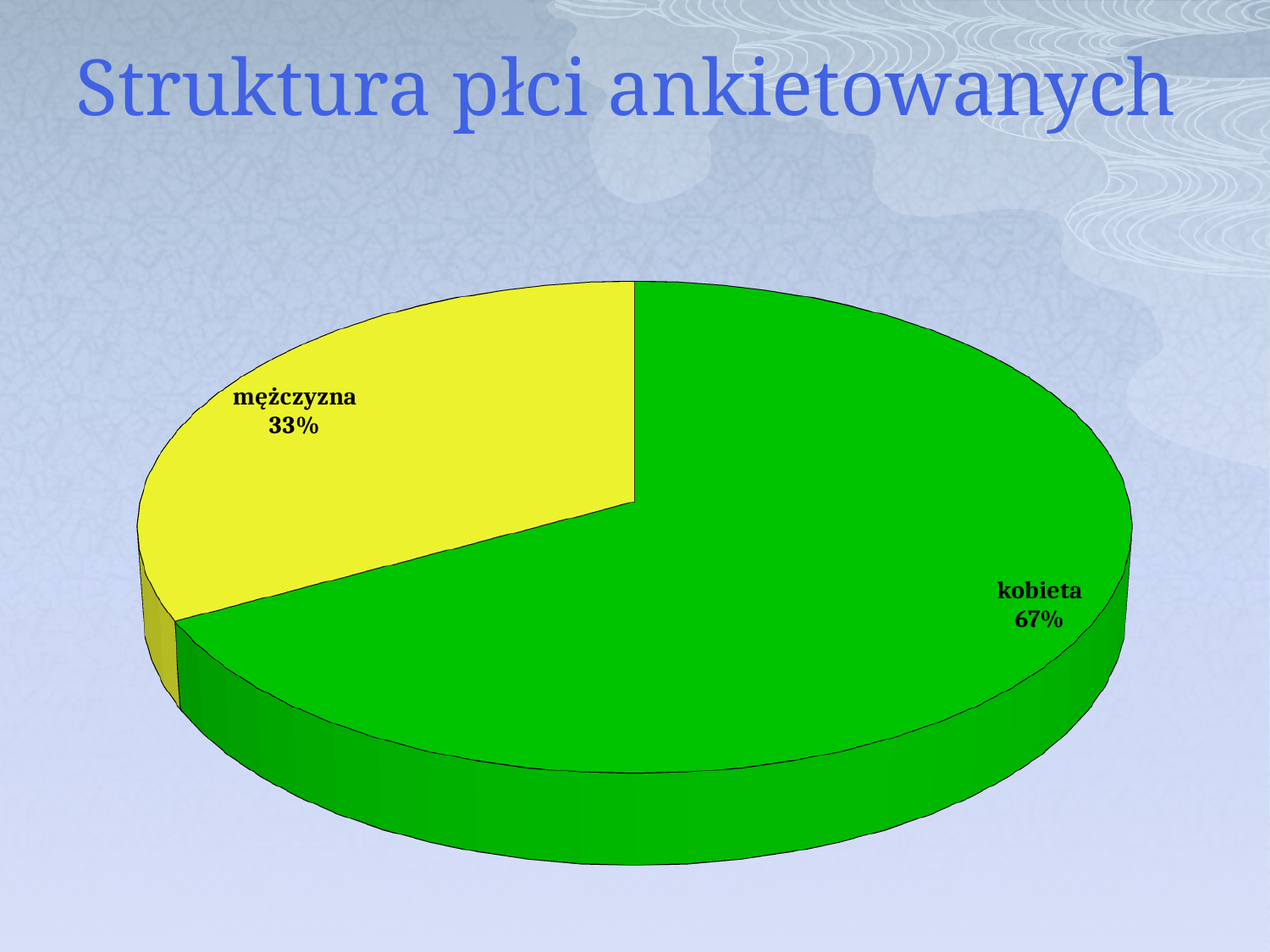
Which category has the largest slice of the pie? kobieta What is the difference in percentage points between the 'kobieta' and 'mężczyzna' slices? 34 What kind of chart is shown on the slide? pie chart What colour is the 'mężczyzna' slice? yellow How many slices does the pie chart have? 2 What is the title of the chart on the slide? Struktura płci ankietowanych What share of the pie does the 'mężczyzna' slice represent? 33% Which slice is larger, 'kobieta' or 'mężczyzna'? kobieta What share of the pie does the 'kobieta' slice represent? 67% Which category has the smallest slice of the pie? mężczyzna